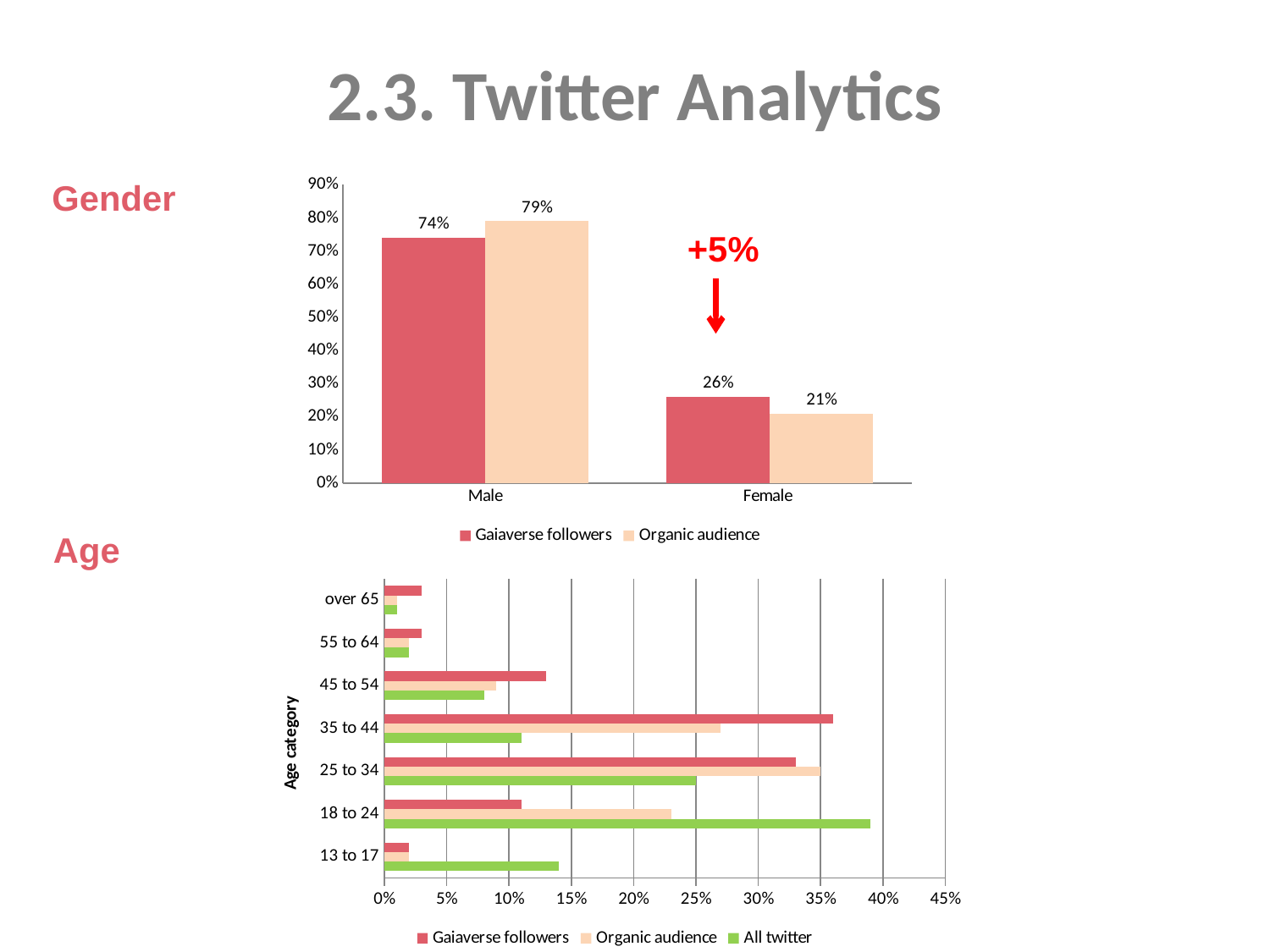
In the Age chart, which series has the larger value for 13 to 17, Gaiaverse followers or All twitter? All twitter In the Gender chart, which series has the larger value for Female, Gaiaverse followers or Organic audience? Gaiaverse followers In the Age chart, is the Gaiaverse followers value for 35 to 44 greater or less than 30%? greater In the Gender chart, what is the value for Organic audience in the Female category? 21% In the Gender chart, how many series does the legend list? 2 In the Gender chart, what is the difference between the Organic audience and Gaiaverse followers values for Male? 5% In the Age chart, is the All twitter value for 18 to 24 greater or less than 35%? greater What kind of chart is the Age chart? Bar chart In the Gender chart, what is the value for Gaiaverse followers in the Male category? 74% In the Age chart, how many series does the legend list? 3 In the Age chart, which age category has the highest Gaiaverse followers value? 35 to 44 In the Age chart, how many age categories are shown? 7